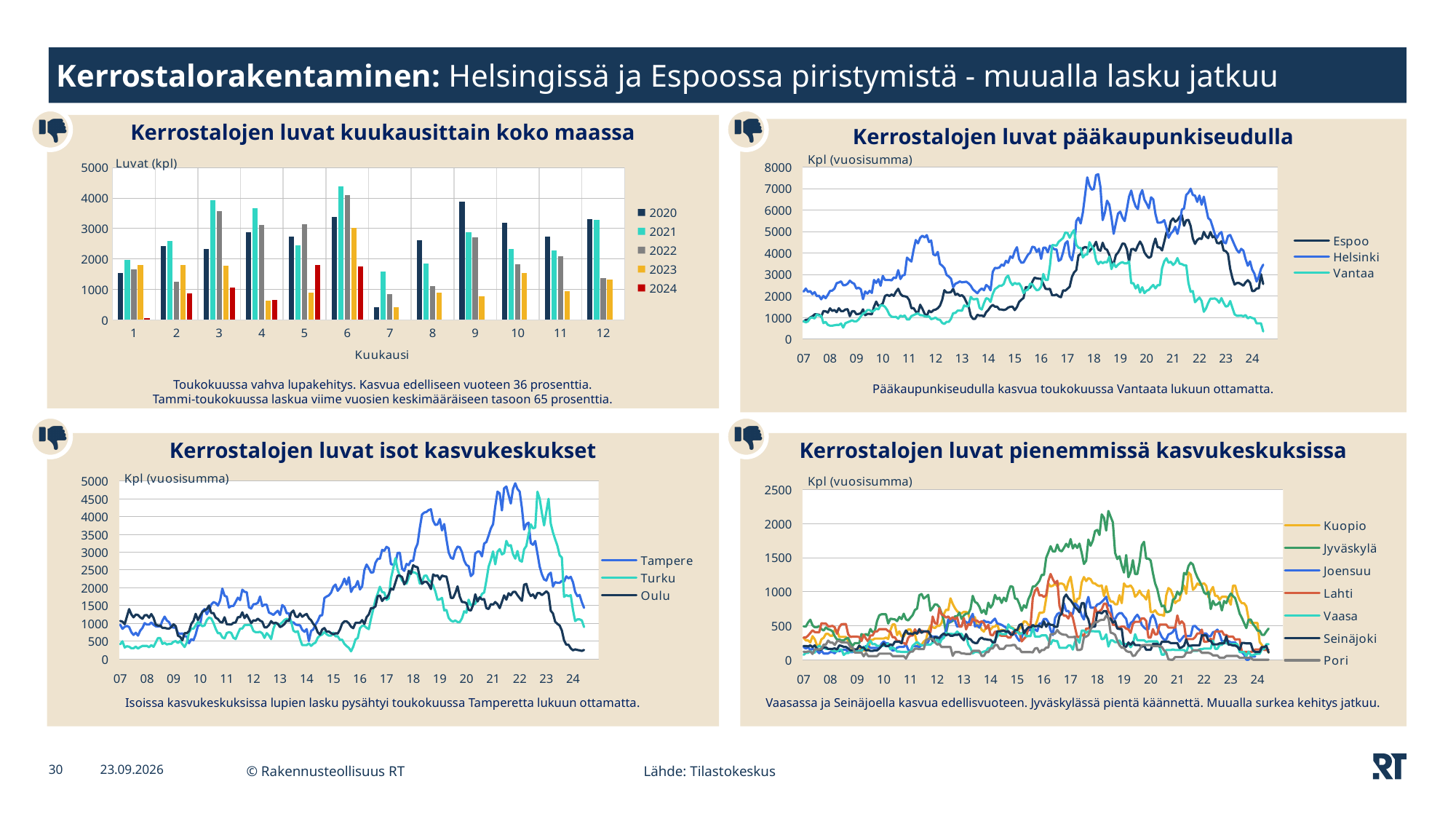
What kind of chart is "Kerrostalojen luvat pääkaupunkiseudulla"? line chart How many series does the legend of "Kerrostalojen luvat kuukausittain koko maassa" list? 5 In "Kerrostalojen luvat kuukausittain koko maassa", is the 2024 value for month 1 greater or less than 1000? less Which series are listed in the legend of "Kerrostalojen luvat pääkaupunkiseudulla"? Espoo, Helsinki, Vantaa What kind of chart is "Kerrostalojen luvat kuukausittain koko maassa"? bar chart How many months (categories) are shown on the x axis of "Kerrostalojen luvat kuukausittain koko maassa"? 12 How many series does the legend of "Kerrostalojen luvat pienemmissä kasvukeskuksissa" list? 7 In "Kerrostalojen luvat kuukausittain koko maassa", which year has the highest bar in month 6? 2021 In "Kerrostalojen luvat isot kasvukeskukset", which series reaches the highest value? Tampere In "Kerrostalojen luvat kuukausittain koko maassa", which is larger in month 5: the 2022 bar or the 2023 bar? 2022 In "Kerrostalojen luvat kuukausittain koko maassa", is the 2021 value for month 6 greater or less than 4000? greater In "Kerrostalojen luvat pääkaupunkiseudulla", is the peak value of Helsinki greater or less than 7000? greater